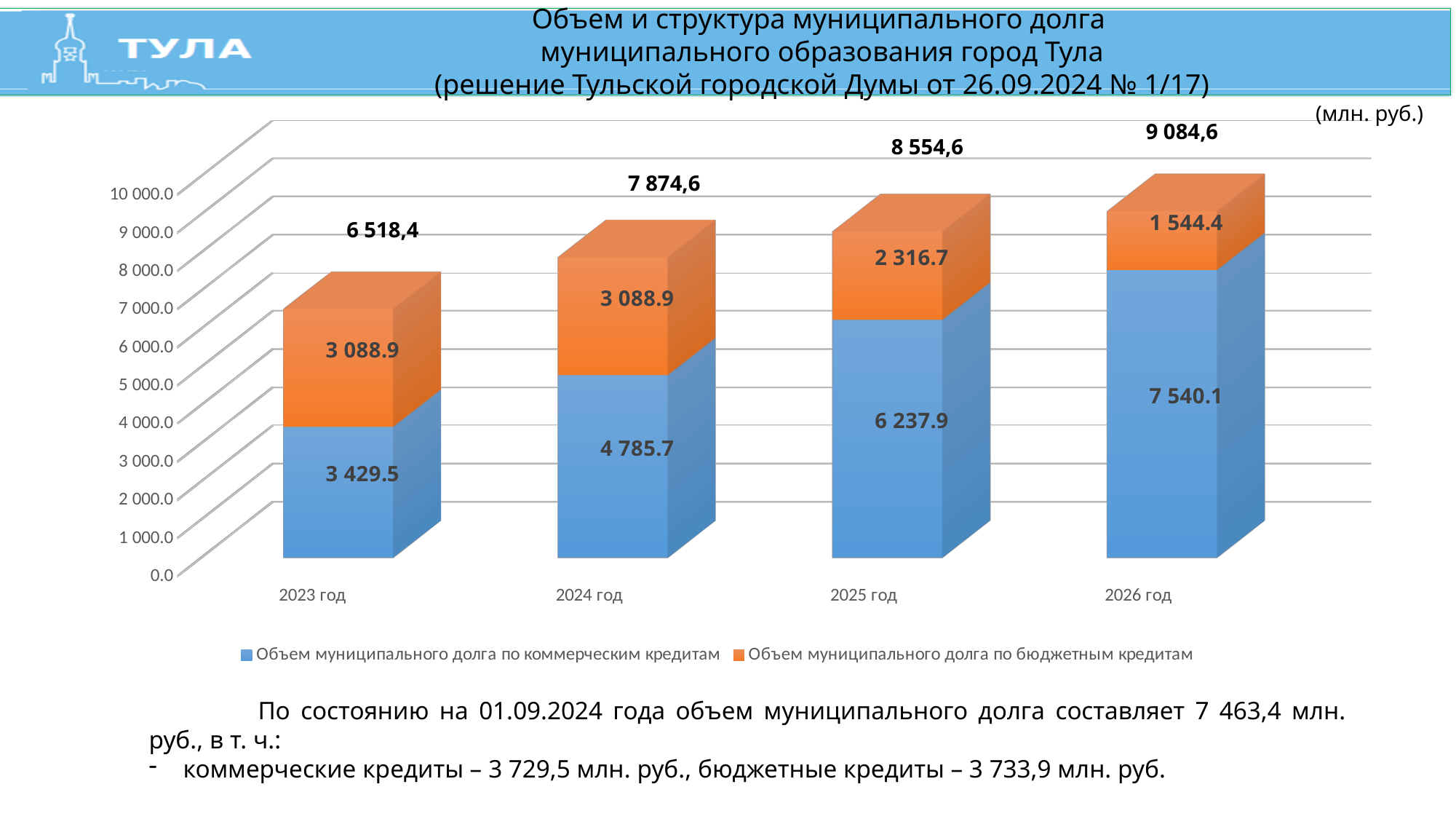
What is the value of municipal debt on budget credits (Объем муниципального долга по бюджетным кредитам) for 2026 год? 1 544.4 What kind of chart is shown on the slide? Stacked bar chart What is the total municipal debt shown above the bar for 2025 год? 8 554,6 Which year has the highest value for municipal debt on commercial credits? 2026 год Is the total municipal debt for 2024 год greater or less than 7 000.0? greater Which year has the lowest value for municipal debt on budget credits? 2026 год Which is larger in 2023 год: the debt on commercial credits or the debt on budget credits? Debt on commercial credits (3 429.5) What is the difference between the commercial credit debt in 2026 год and in 2023 год? 4 110.6 How many series does the legend list? 2 How many years are shown on the x axis of the chart? 4 Does the municipal debt on budget credits rise or fall from 2024 год to 2026 год? Fall What is the value of municipal debt on commercial credits (Объем муниципального долга по коммерческим кредитам) for 2024 год? 4 785.7